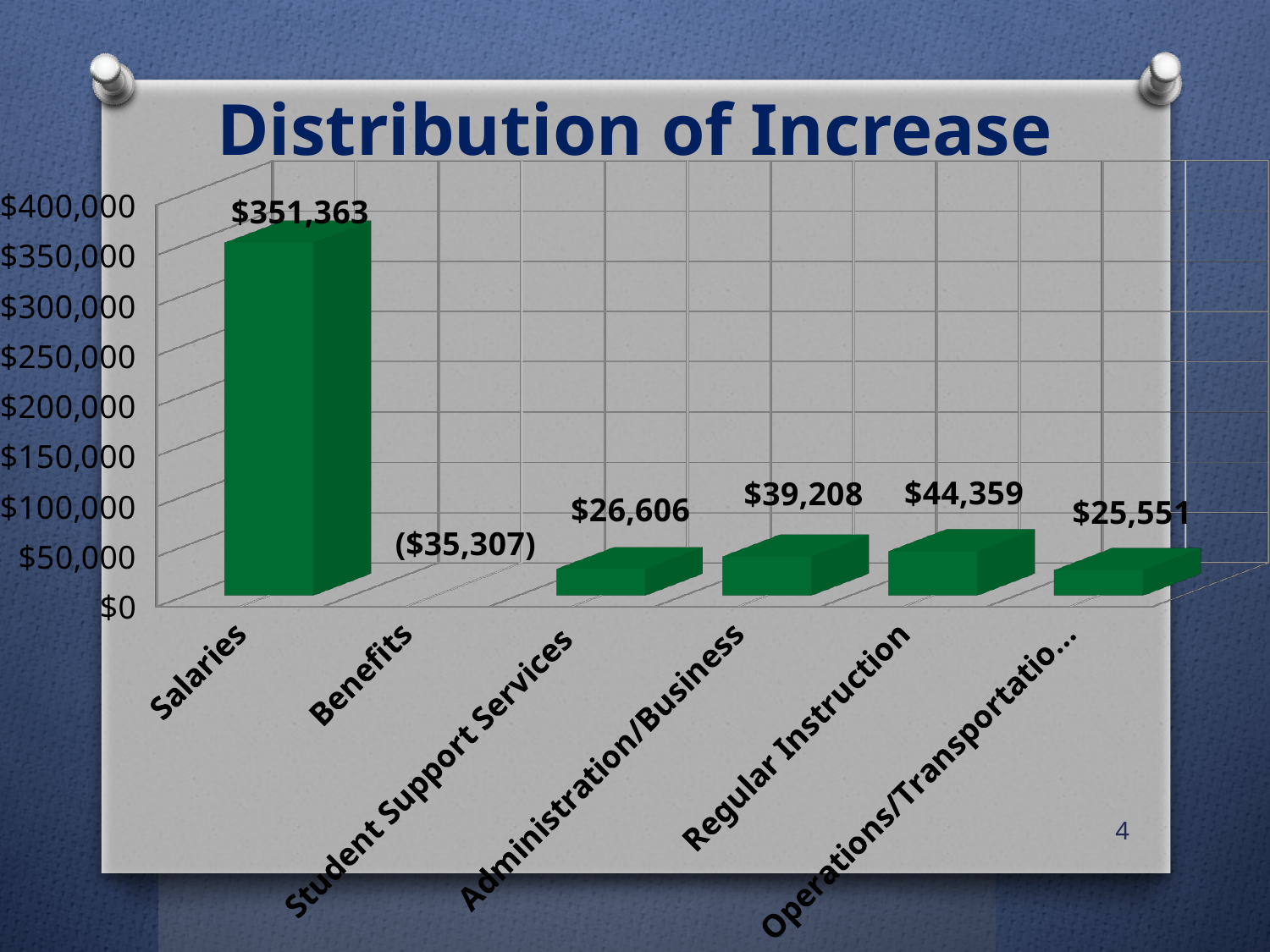
What is the value for Administration/Business? $39,208 How many categories are shown on the x axis? 6 Which category has the highest value? Salaries What is the value for Regular Instruction? $44,359 Which category has the lowest value? Benefits What is the difference between the values for Salaries and Regular Instruction? $307,004 Which is larger, the value for Regular Instruction or the value for Administration/Business? Regular Instruction What type of chart is shown on the slide? bar chart What is the value for Salaries? $351,363 What is the value for Student Support Services? $26,606 What value is shown for Benefits? ($35,307) Is the value for Salaries greater or less than $300,000? greater